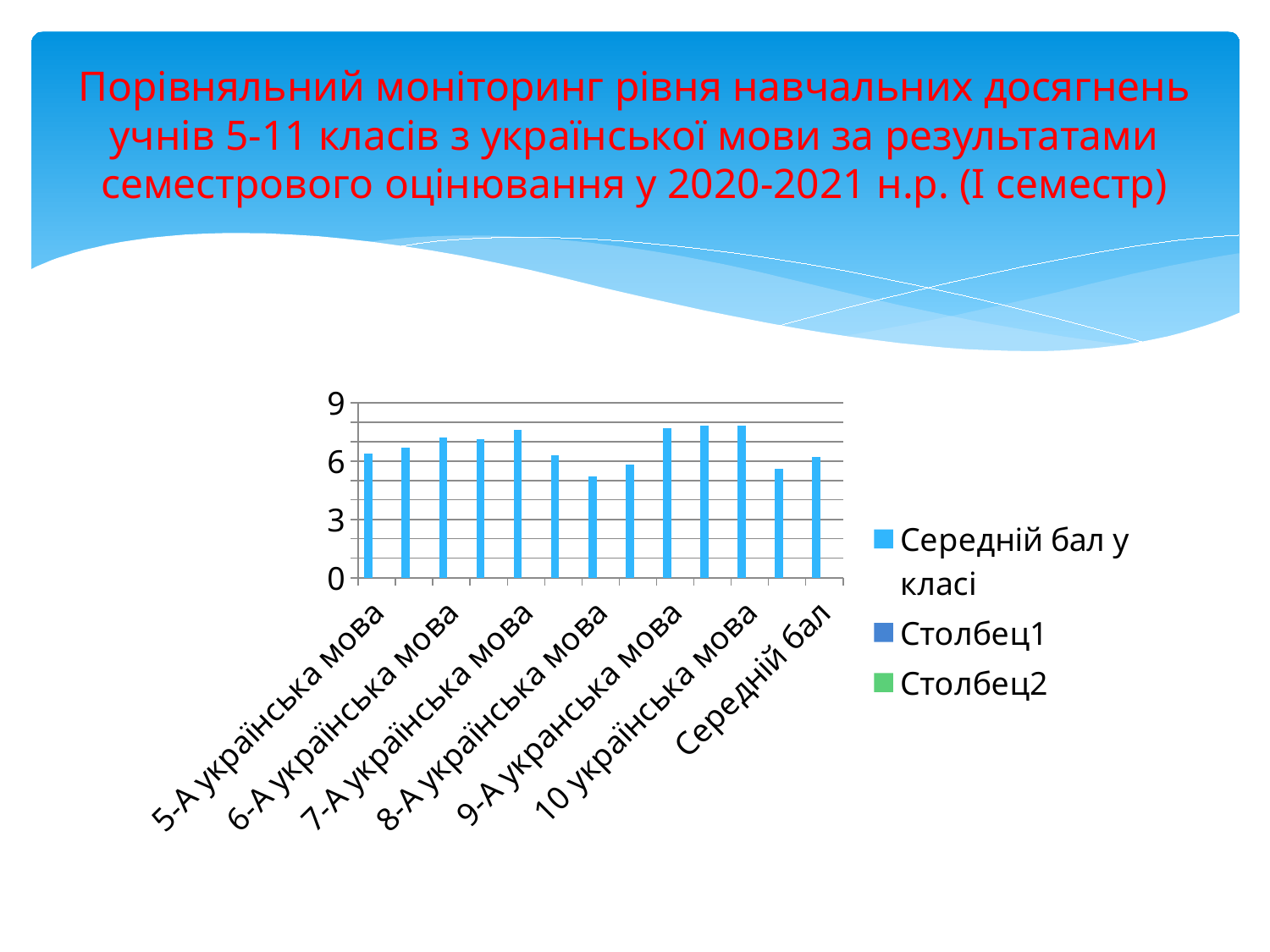
How many bars are plotted in the chart? 13 Is the value for 9-А укранська мова greater or less than 9? less What is the first entry in the chart's legend? Середній бал у класі Which is larger, the value for 5-А українська мова or for 9-А укранська мова? 9-А укранська мова Is the value for 10 українська мова greater or less than 6? greater Which of the labelled categories has the lowest bar? 8-А українська мова What kind of chart is shown on the slide? bar chart Is the value for 7-А українська мова greater or less than 6? greater Which is larger, the value for 7-А українська мова or for 8-А українська мова? 7-А українська мова How many series does the legend list? 3